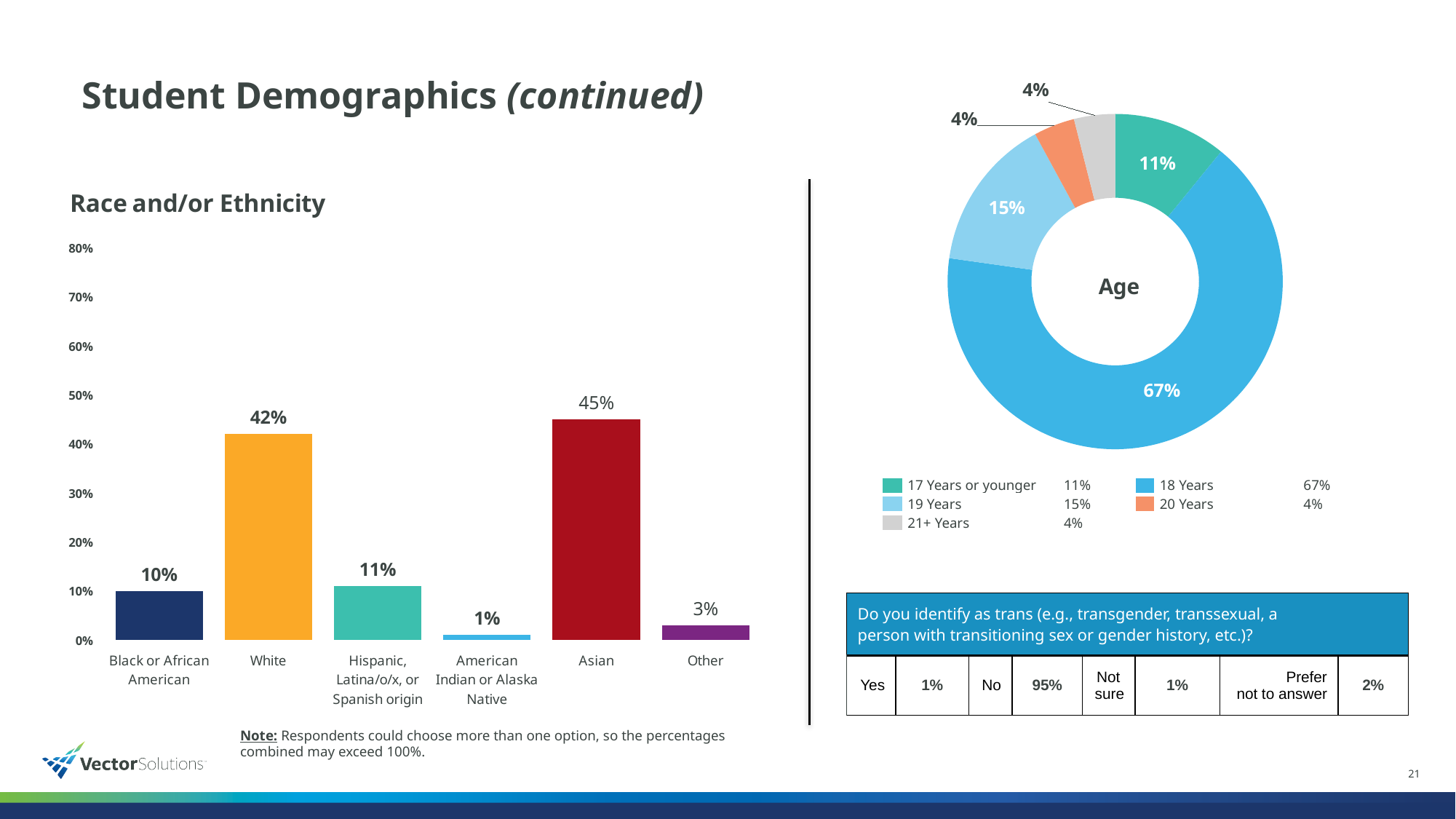
In the Age chart, what is the value for 19 Years? 15% In the Age chart, what share of respondents are 18 Years? 67% What kind of chart is the Race and/or Ethnicity chart? Bar chart In the Race and/or Ethnicity bar chart, what is the value for White? 42% In the Race and/or Ethnicity bar chart, which category has the lowest value? American Indian or Alaska Native What kind of chart is the Age chart? Doughnut chart How many categories are shown in the Race and/or Ethnicity bar chart? 6 In the Race and/or Ethnicity bar chart, which category has the highest value? Asian In the Race and/or Ethnicity bar chart, what is the difference between the values for Asian and White? 3% How many categories does the legend of the Age chart list? 5 In the Race and/or Ethnicity bar chart, what is the value for American Indian or Alaska Native? 1% In the Race and/or Ethnicity bar chart, which is larger: Black or African American or Hispanic, Latina/o/x, or Spanish origin? Hispanic, Latina/o/x, or Spanish origin